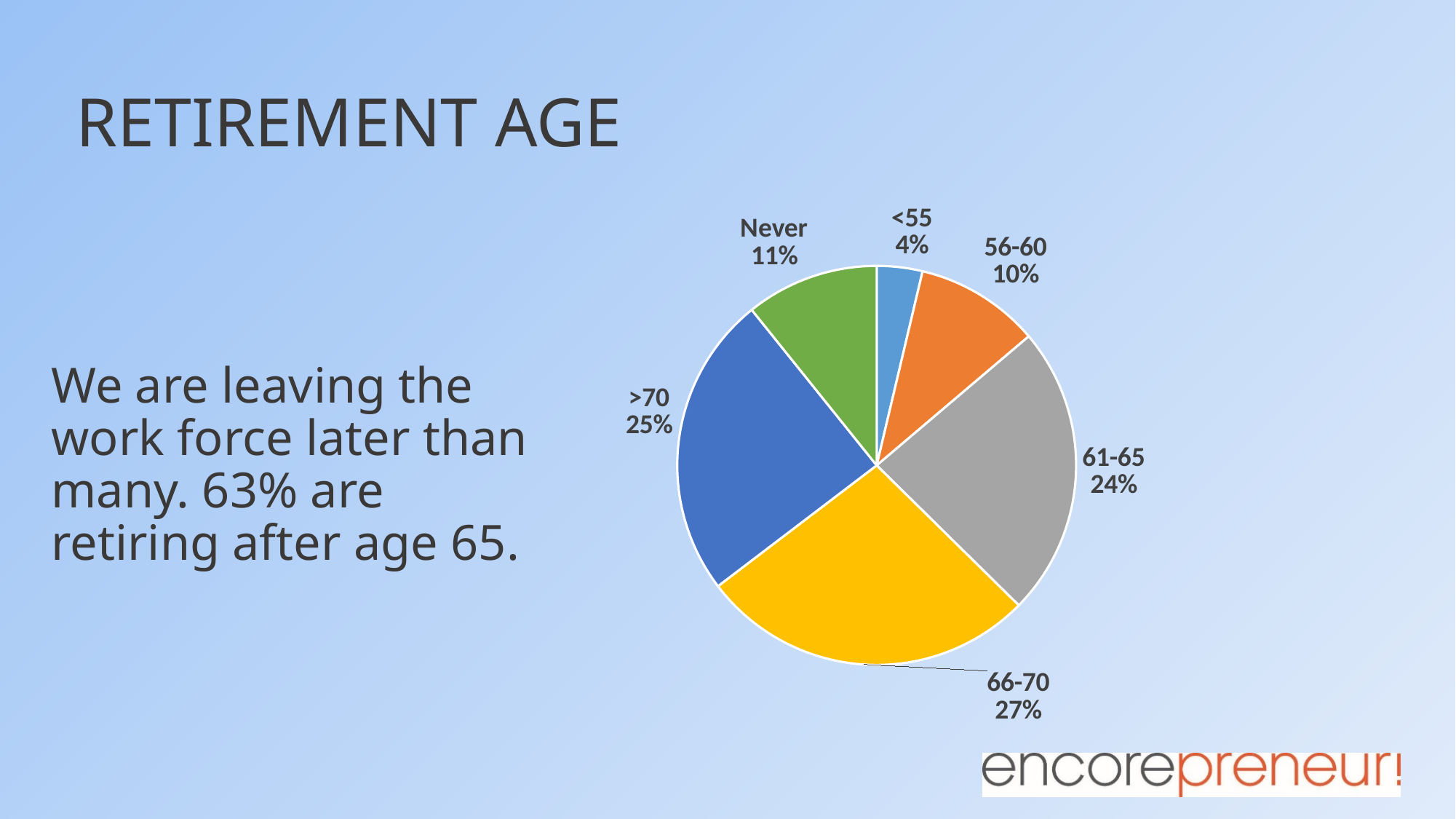
What is the difference between the 61-65 share and the 56-60 share? 14% What kind of chart is shown on the slide? pie chart What is the combined share of the 66-70 and >70 slices? 52% What is the value for the Never category? 11% What is the value for the <55 category? 4% What is the title of the slide containing the chart? RETIREMENT AGE What is the value for the >70 category? 25% How many categories are shown in the pie chart? 6 What share of the pie does the 66-70 slice represent? 27% Which is larger, the share for 61-65 or the share for Never? 61-65 Which category has the smallest share of the pie? <55 Which category has the largest share of the pie? 66-70